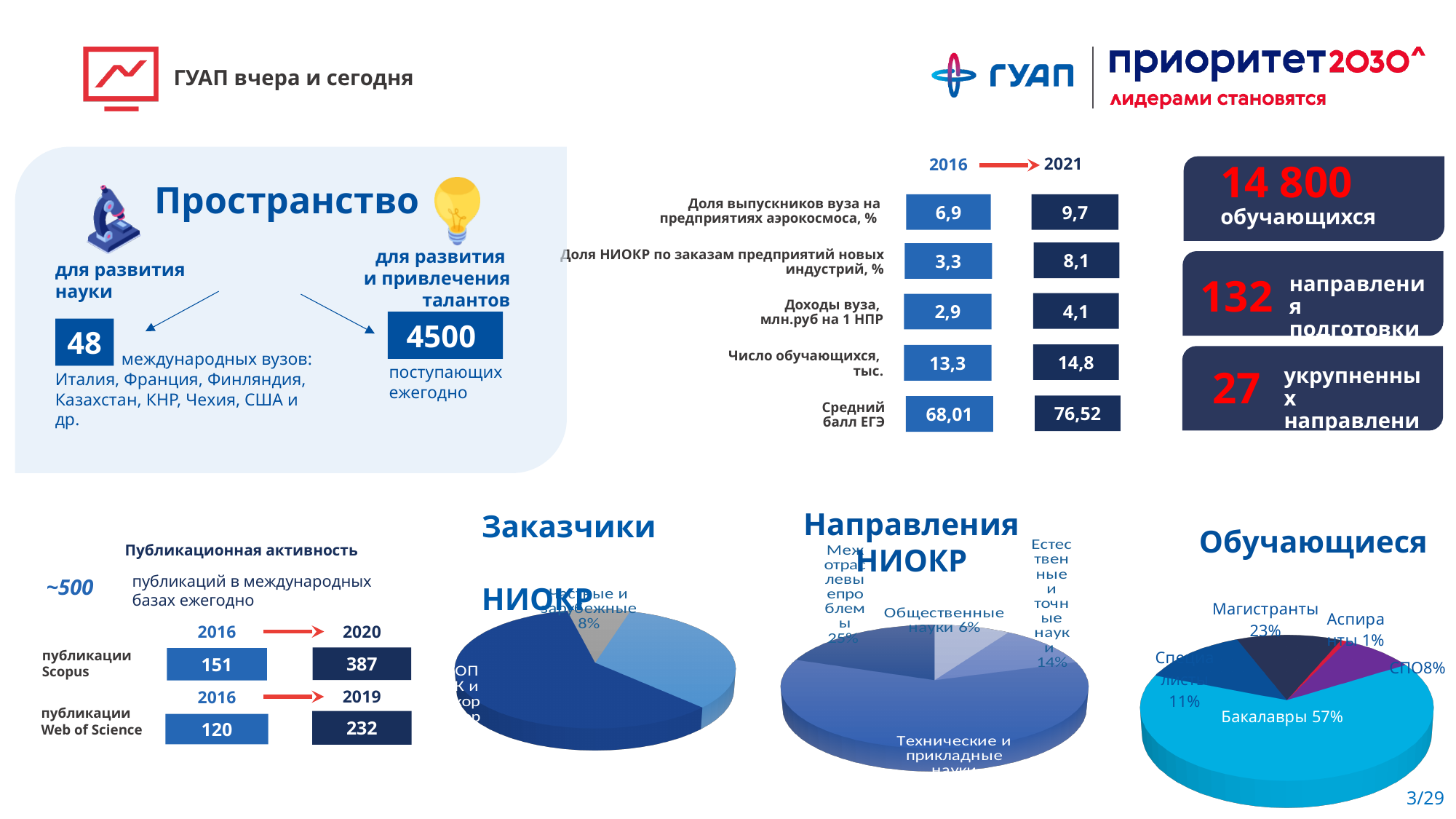
In the 'Обучающиеся' pie chart, what is the value for Магистранты? 23% In the 'Направления НИОКР' pie chart, which is larger: Общественные науки or Естественные и точные науки? Естественные и точные науки In the 'Обучающиеся' pie chart, what share do Бакалавры have? 57% In the 'Обучающиеся' pie chart, what is the difference between the shares of Магистранты and Специалисты? 12 percentage points In the 'Направления НИОКР' pie chart, what is the value for Межотраслевые проблемы? 25% In the 'Обучающиеся' pie chart, which category has the largest slice? Бакалавры In the 'Обучающиеся' pie chart, what is the value for СПО? 8% What kind of chart is the 'Заказчики НИОКР' chart? Pie chart How many slices does the 'Обучающиеся' pie chart have? 5 In the 'Направления НИОКР' pie chart, which category has the largest slice? Технические и прикладные науки In the 'Обучающиеся' pie chart, which category has the smallest slice? Аспиранты In the 'Направления НИОКР' pie chart, what is the value for Естественные и точные науки? 14%